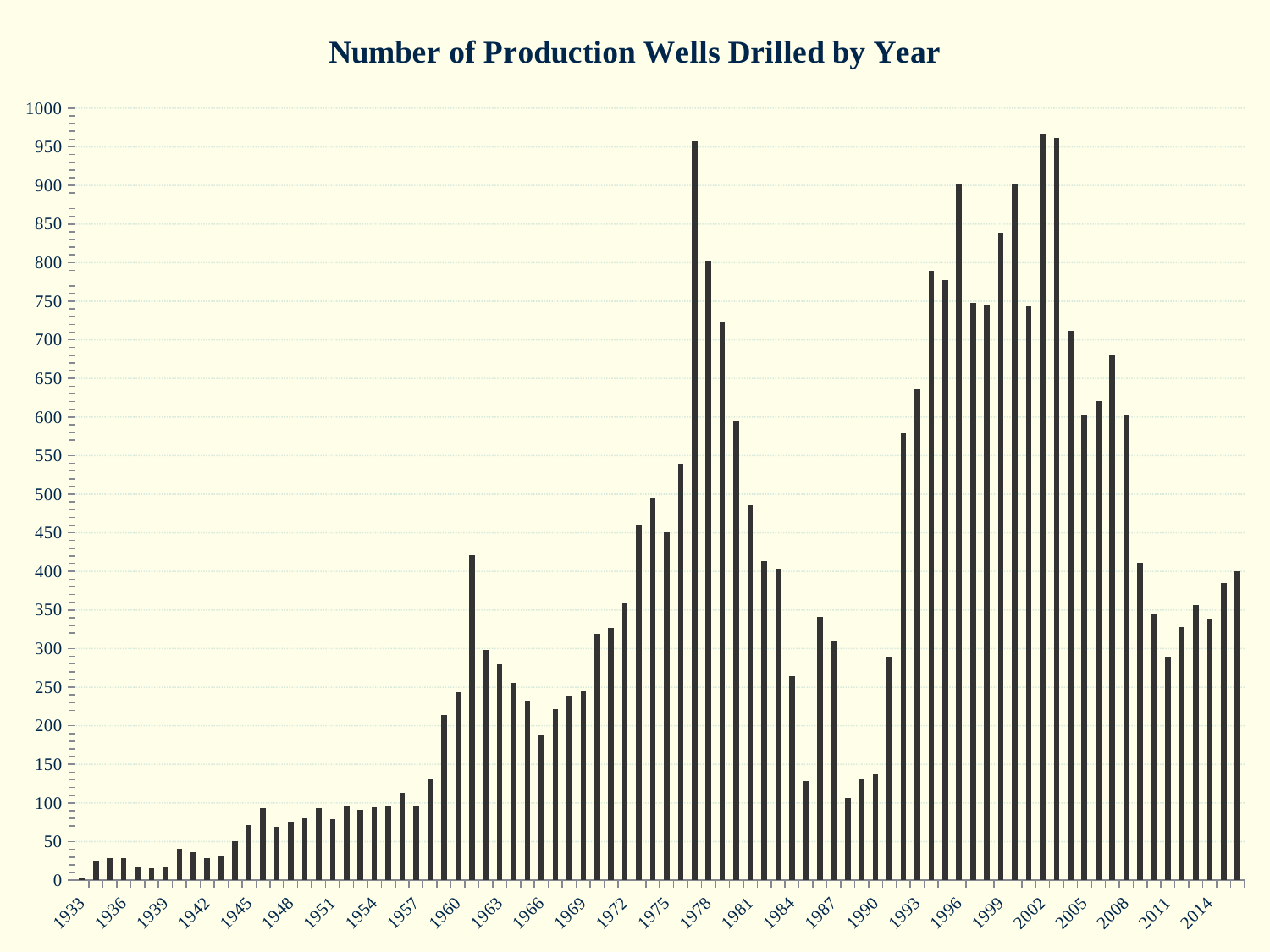
Which year has the lowest number of production wells drilled? 1933 Do the values generally rise or fall from 1933 to 1945? rise Is the value for 1966 greater or less than 200? less Which year has the larger value, 1977 or 1984? 1977 What is the title of the chart? Number of Production Wells Drilled by Year Which year has the larger value, 1993 or 1987? 1993 What kind of chart is shown on the slide? bar chart Is the value for 1960 greater or less than 400? less Is the value for 1996 greater or less than 850? greater Do the values generally rise or fall from 2002 to 2011? fall